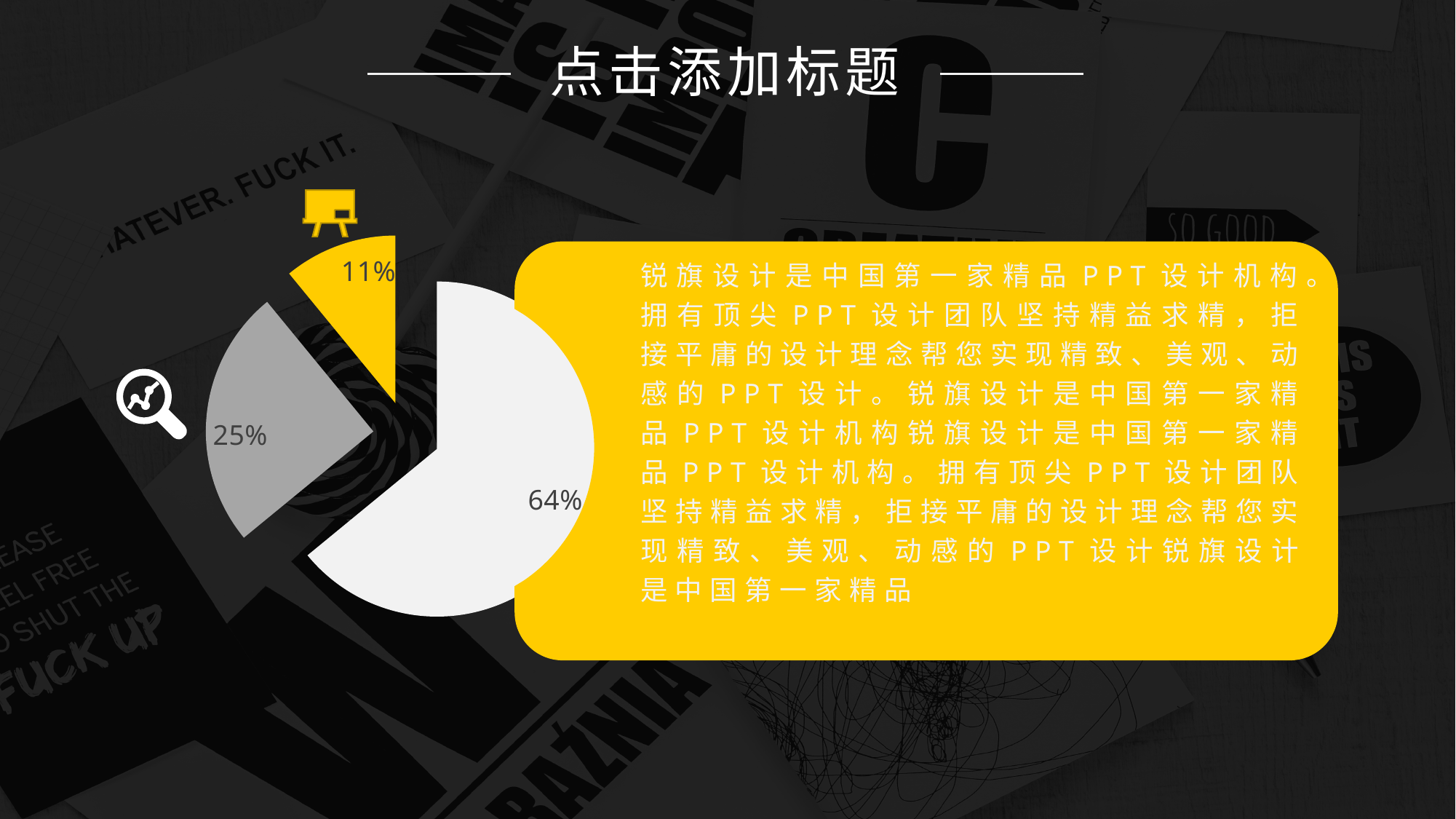
What kind of chart is shown on the slide? pie chart What percentage is shown on the yellow slice of the pie chart? 11% What percentage is shown on the gray slice of the pie chart? 25% How many slices does the pie chart have? 3 Which slice of the pie chart is the largest? the white slice (64%) Which slice of the pie chart is the smallest? the yellow slice (11%) What percentage is shown on the white slice of the pie chart? 64% What is the combined share of the yellow and gray slices of the pie chart? 36% Which is larger in the pie chart, the gray slice or the yellow slice? the gray slice What is the difference between the white slice and the gray slice of the pie chart? 39% What is the difference between the gray slice and the yellow slice of the pie chart? 14% What colour is the largest slice of the pie chart? white